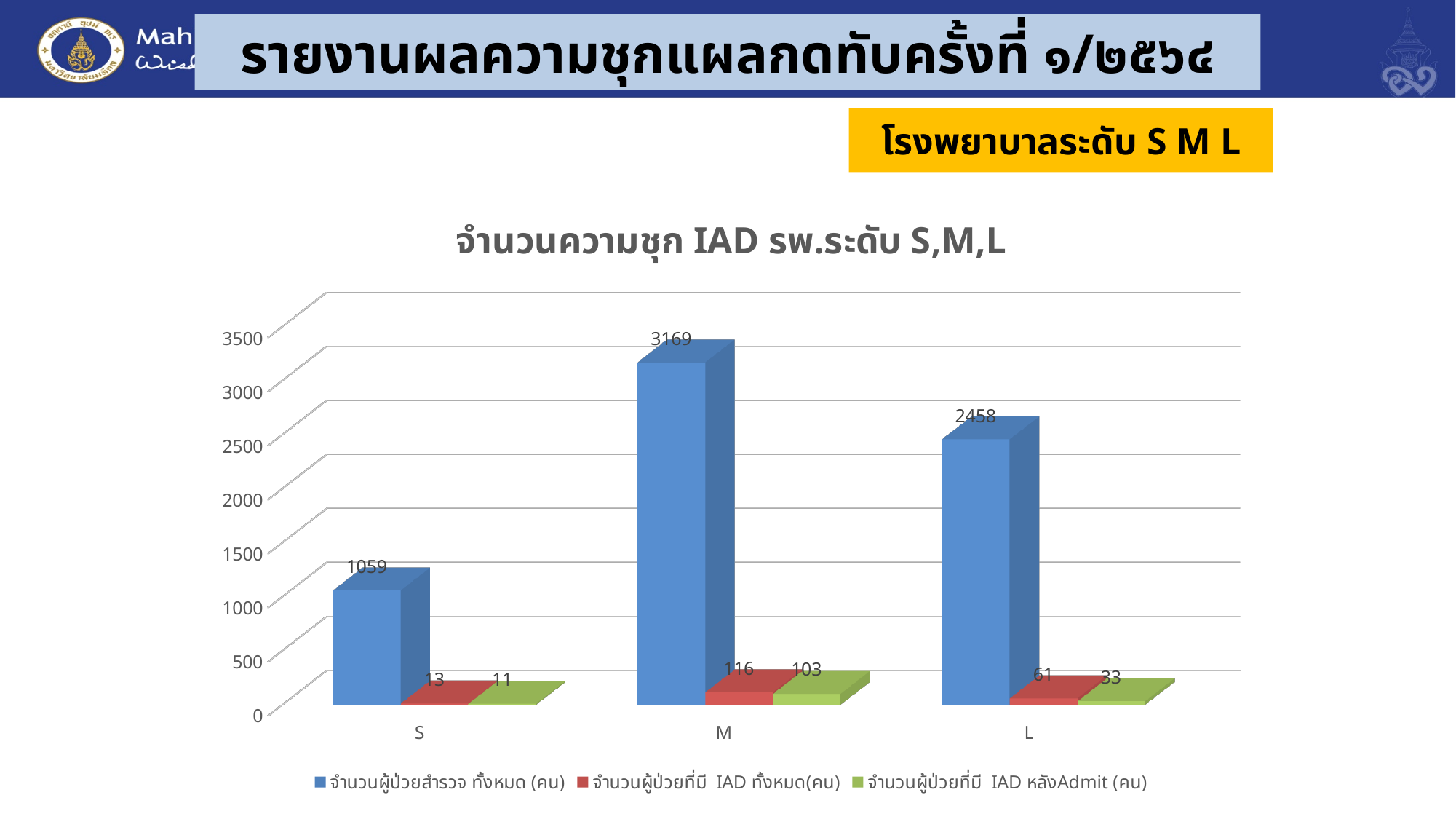
What kind of chart is shown on the slide? Bar chart Which hospital level has the lowest value for จำนวนผู้ป่วยที่มี IAD ทั้งหมด(คน)? S What is the value of จำนวนผู้ป่วยที่มี IAD หลังAdmit (คน) for hospital level S? 11 How many hospital level categories are shown on the x axis? 3 What is the value of จำนวนผู้ป่วยที่มี IAD ทั้งหมด(คน) for hospital level L? 61 What is the difference between จำนวนผู้ป่วยที่มี IAD ทั้งหมด(คน) and จำนวนผู้ป่วยที่มี IAD หลังAdmit (คน) for hospital level M? 13 How many series does the legend list? 3 Is the value of จำนวนผู้ป่วยสำรวจ ทั้งหมด (คน) for hospital level L greater or less than 2000? greater What is the value of จำนวนผู้ป่วยสำรวจ ทั้งหมด (คน) for hospital level M? 3169 What is the difference between จำนวนผู้ป่วยสำรวจ ทั้งหมด (คน) for M and for L? 711 Which is larger: จำนวนผู้ป่วยที่มี IAD หลังAdmit (คน) for M or for L? M Which hospital level has the highest value for จำนวนผู้ป่วยสำรวจ ทั้งหมด (คน)? M